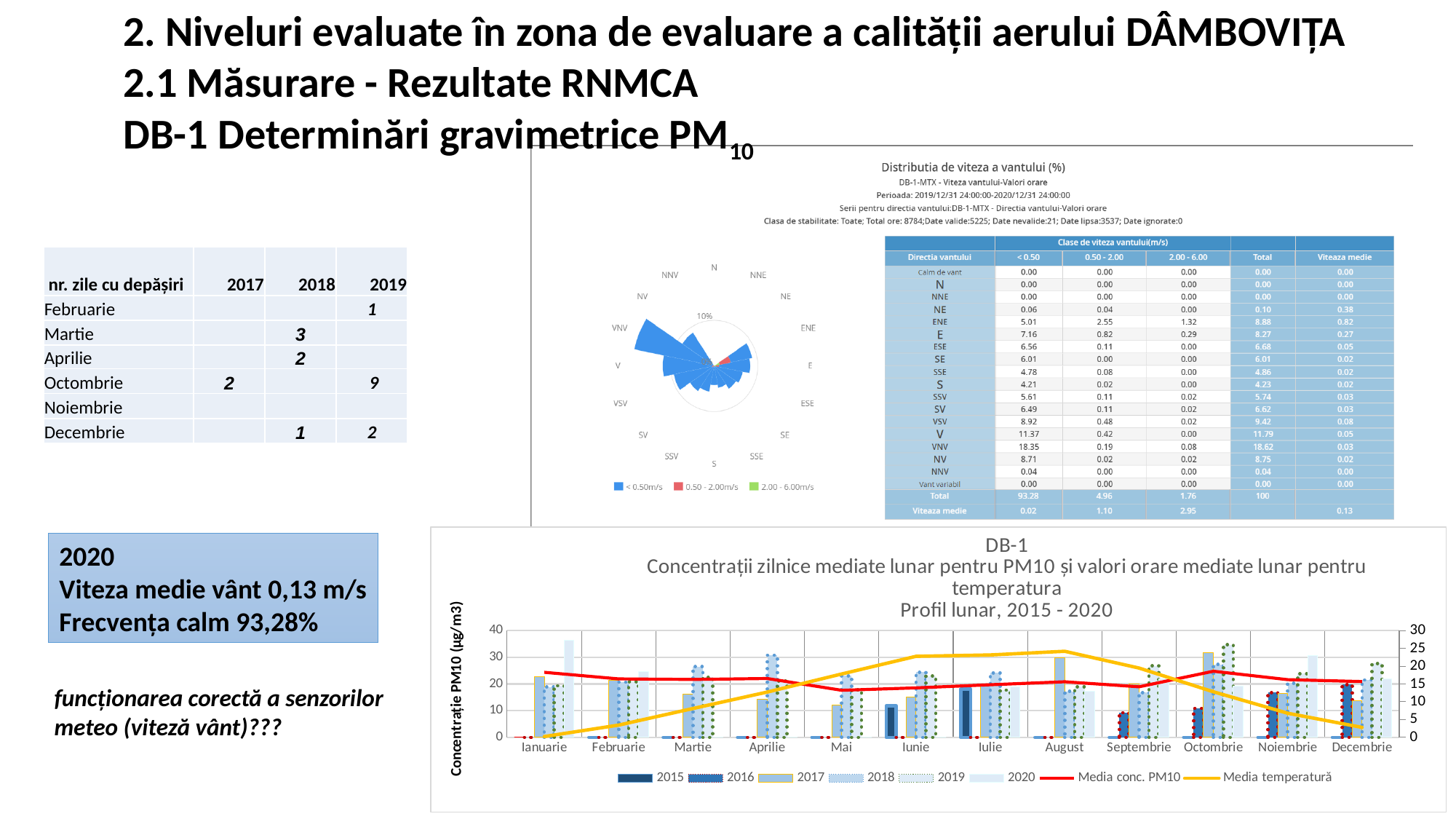
In the bottom chart (DB-1 Profil lunar, 2015 - 2020), what is the label of the left vertical axis? Concentrație PM10 (µg/m3) In the table next to the wind rose chart 'Distributia de viteza a vantului (%)', what is the Total value for the VNV direction? 18.62 In the bottom chart (DB-1 Profil lunar, 2015 - 2020), how many months are shown on the x axis? 12 In the wind rose chart 'Distributia de viteza a vantului (%)', which wind direction has the largest share? VNV How many series does the legend of the bottom chart (DB-1 Profil lunar, 2015 - 2020) list? 8 In the bottom chart (DB-1 Profil lunar, 2015 - 2020), is the 2019 bar for Octombrie greater or less than 30? greater In the bottom chart (DB-1 Profil lunar, 2015 - 2020), is the 2020 bar for Ianuarie greater or less than 30? greater In the bottom chart (DB-1 Profil lunar, 2015 - 2020), is the 2015 bar for Iunie greater or less than 20? less How many wind speed classes does the legend of the wind rose chart 'Distributia de viteza a vantului (%)' list? 3 In the bottom chart (DB-1 Profil lunar, 2015 - 2020), which line is drawn in red? Media conc. PM10 In the bottom chart (DB-1 Profil lunar, 2015 - 2020), does the 'Media temperatură' line rise or fall from Ianuarie to August? rises What kind of chart is the bottom chart titled 'DB-1 Concentrații zilnice mediate lunar pentru PM10 și valori orare mediate lunar pentru temperatura'? A combined bar and line chart